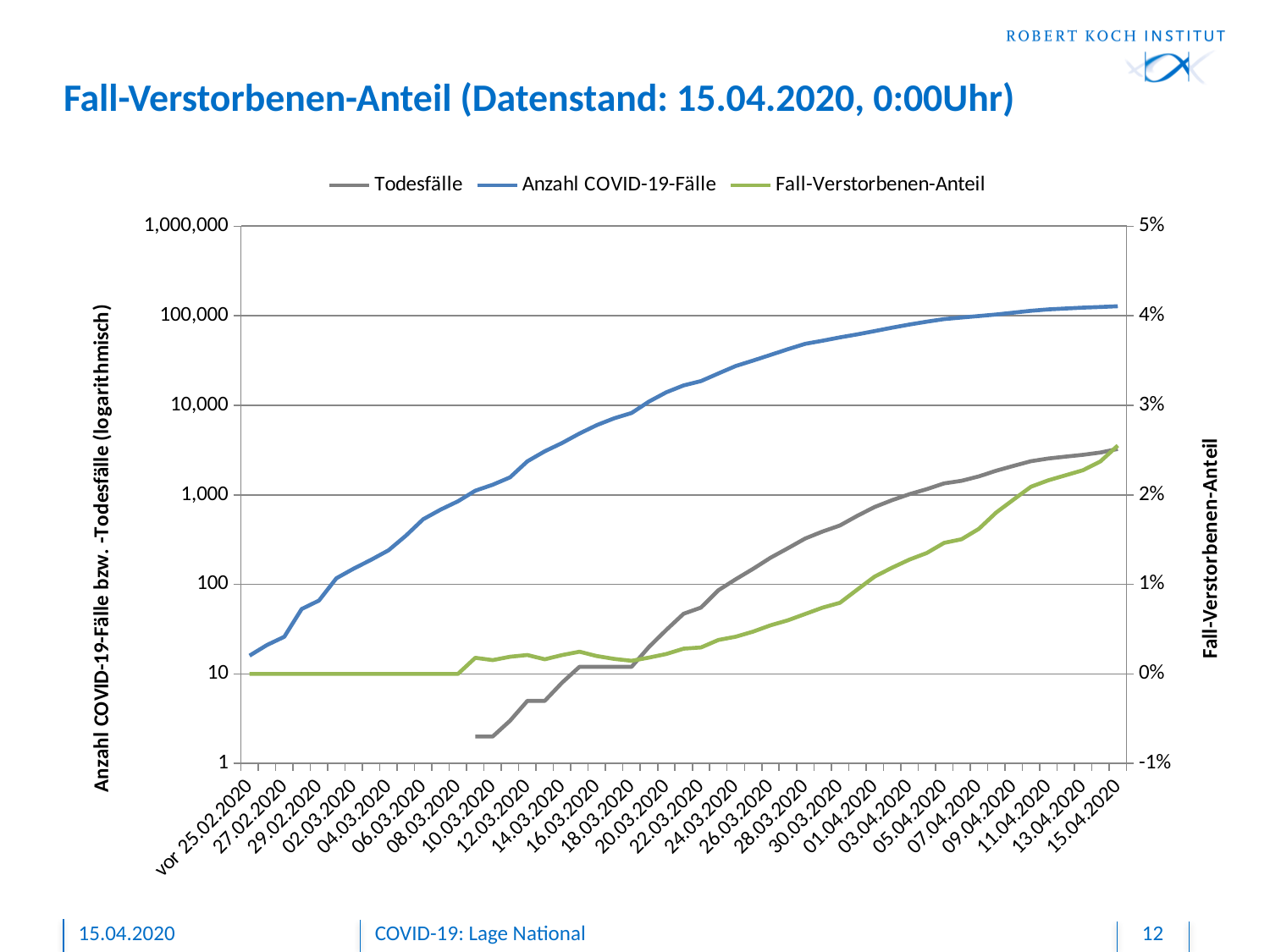
Is the value for Todesfälle on 15.04.2020 greater or less than 1,000? greater Which colour is used for the Anzahl COVID-19-Fälle series? blue Is the value for Anzahl COVID-19-Fälle on 28.03.2020 greater or less than 10,000? greater How many series does the legend list? 3 What is the title of the chart on the slide? Fall-Verstorbenen-Anteil (Datenstand: 15.04.2020, 0:00Uhr) Is the value for Anzahl COVID-19-Fälle on 15.04.2020 greater or less than 100,000? greater What kind of chart is shown on the slide? line chart On 15.04.2020, which is larger: Anzahl COVID-19-Fälle or Todesfälle? Anzahl COVID-19-Fälle Does the Anzahl COVID-19-Fälle series rise or fall from vor 25.02.2020 to 15.04.2020? rise